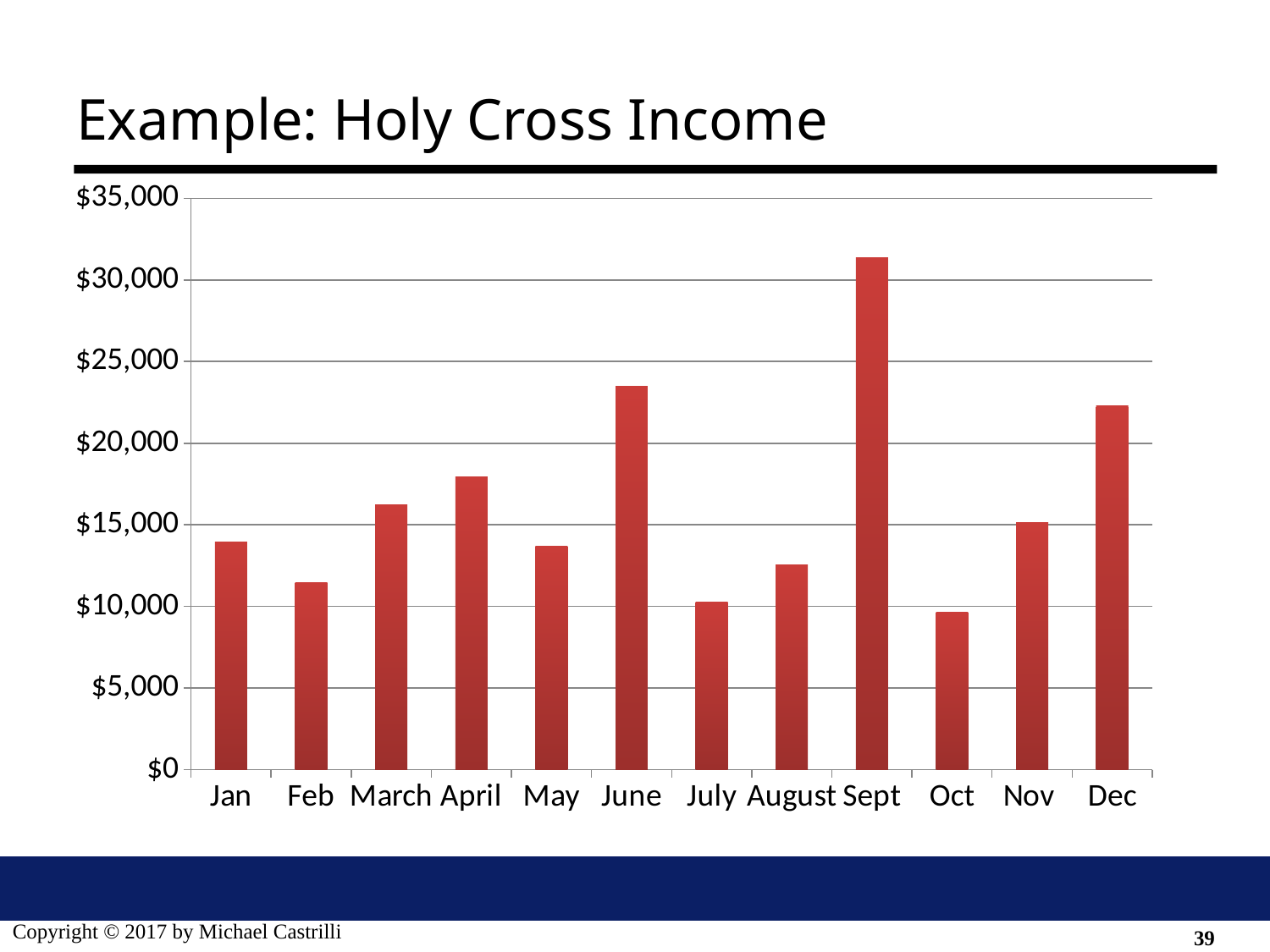
What is the title of the slide containing the chart? Example: Holy Cross Income Is the value for April greater or less than $20,000? less Which month has the lowest income in the chart? Oct Which month has the highest income in the chart? Sept Is the value for March greater or less than $15,000? greater Is the value for June greater or less than $20,000? greater What kind of chart is shown on the slide? Bar chart How many months are shown on the x axis of the chart? 12 Which month has the larger income, March or April? April Which month has the larger income, Sept or June? Sept